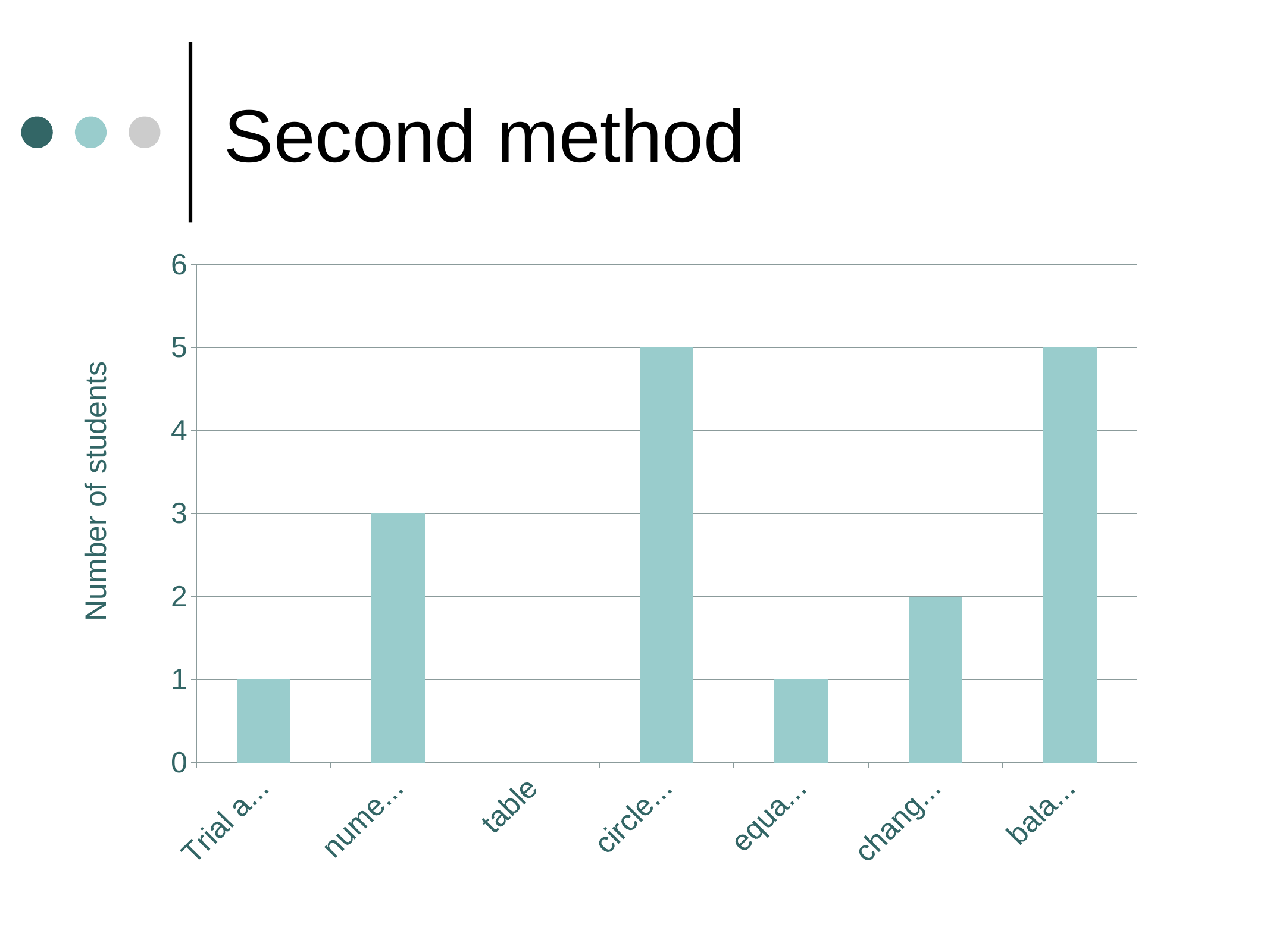
What is the label of the vertical axis? Number of students Which has more students, the "nume…" category or the "chang…" category? nume… What is the title of the slide containing the chart? Second method What is the number of students for the category labelled "table"? 0 Which category has the lowest number of students? table What kind of chart is shown on the slide? bar chart How many categories are shown on the x axis of the chart? 7 What is the number of students for the category labelled "chang…"? 2 What is the difference in number of students between the "circle…" category and the "nume…" category? 2 What is the number of students for the first category, labelled "Trial a…"? 1 What is the number of students for the category labelled "nume…"? 3 What is the number of students for the last category, labelled "bala…"? 5